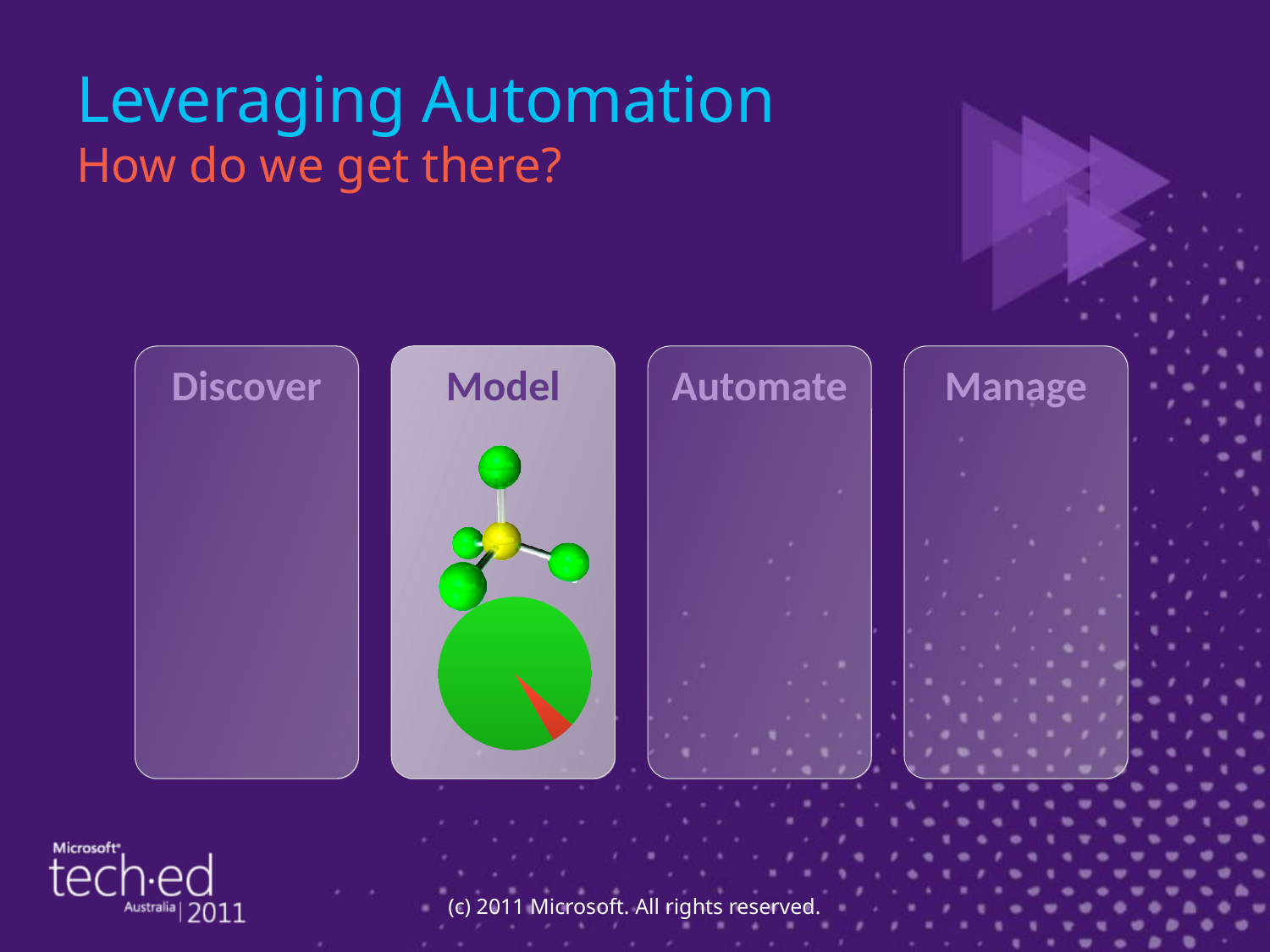
Which slice of the pie chart in the Model panel is the largest? the green slice Under which of the four panel headings does the pie chart appear? Model Which slice of the pie chart in the Model panel is the smallest? the red slice How many slices does the pie chart in the Model panel have? 2 What kind of chart is shown in the Model panel? pie chart In the pie chart in the Model panel, which slice is larger, the green one or the red one? green What colours are the slices of the pie chart in the Model panel? green and red